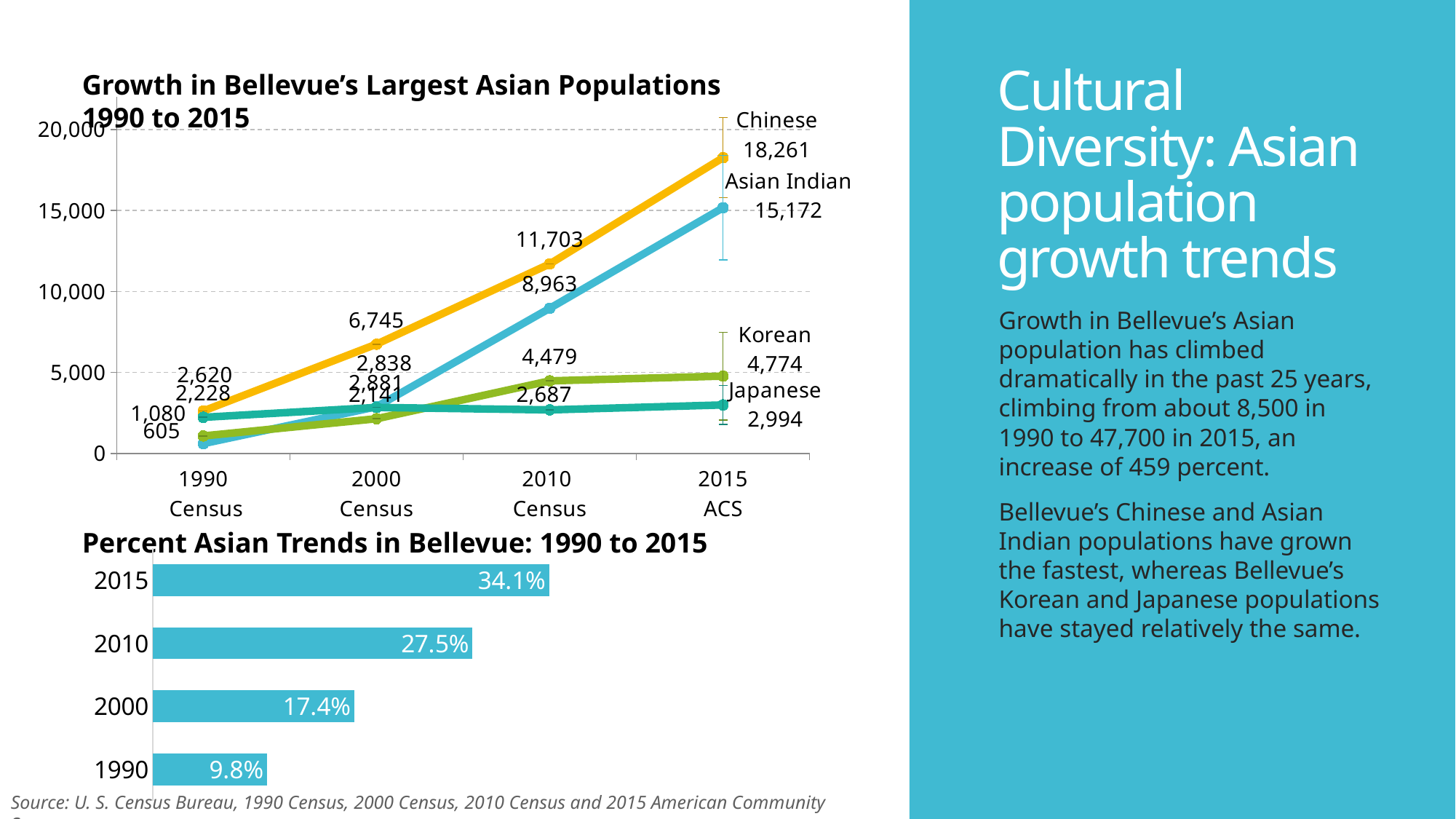
In the 'Growth in Bellevue's Largest Asian Populations' chart, which population is the largest in 2015? Chinese In the 'Growth in Bellevue's Largest Asian Populations' chart, what is the Asian Indian population in the 2010 Census? 8,963 In the 'Percent Asian Trends in Bellevue' chart, what is the value for 2015? 34.1% How many years are shown in the 'Percent Asian Trends in Bellevue' chart? 4 In the 'Growth in Bellevue's Largest Asian Populations' chart, what is the difference between the Chinese and Asian Indian populations in 2015? 3,089 In the 'Growth in Bellevue's Largest Asian Populations' chart, what is the Korean population in 2015? 4,774 How many population series are plotted in the 'Growth in Bellevue's Largest Asian Populations' chart? 4 In the 'Percent Asian Trends in Bellevue' chart, what is the value for 1990? 9.8% In the 'Growth in Bellevue's Largest Asian Populations' chart, what is the Chinese population in 2015? 18,261 In the 'Percent Asian Trends in Bellevue' chart, what is the difference between the 2015 and 2010 values? 6.6 percentage points In the 'Percent Asian Trends in Bellevue' chart, which year has the lowest value? 1990 What kind of chart is the 'Percent Asian Trends in Bellevue' chart? Bar chart